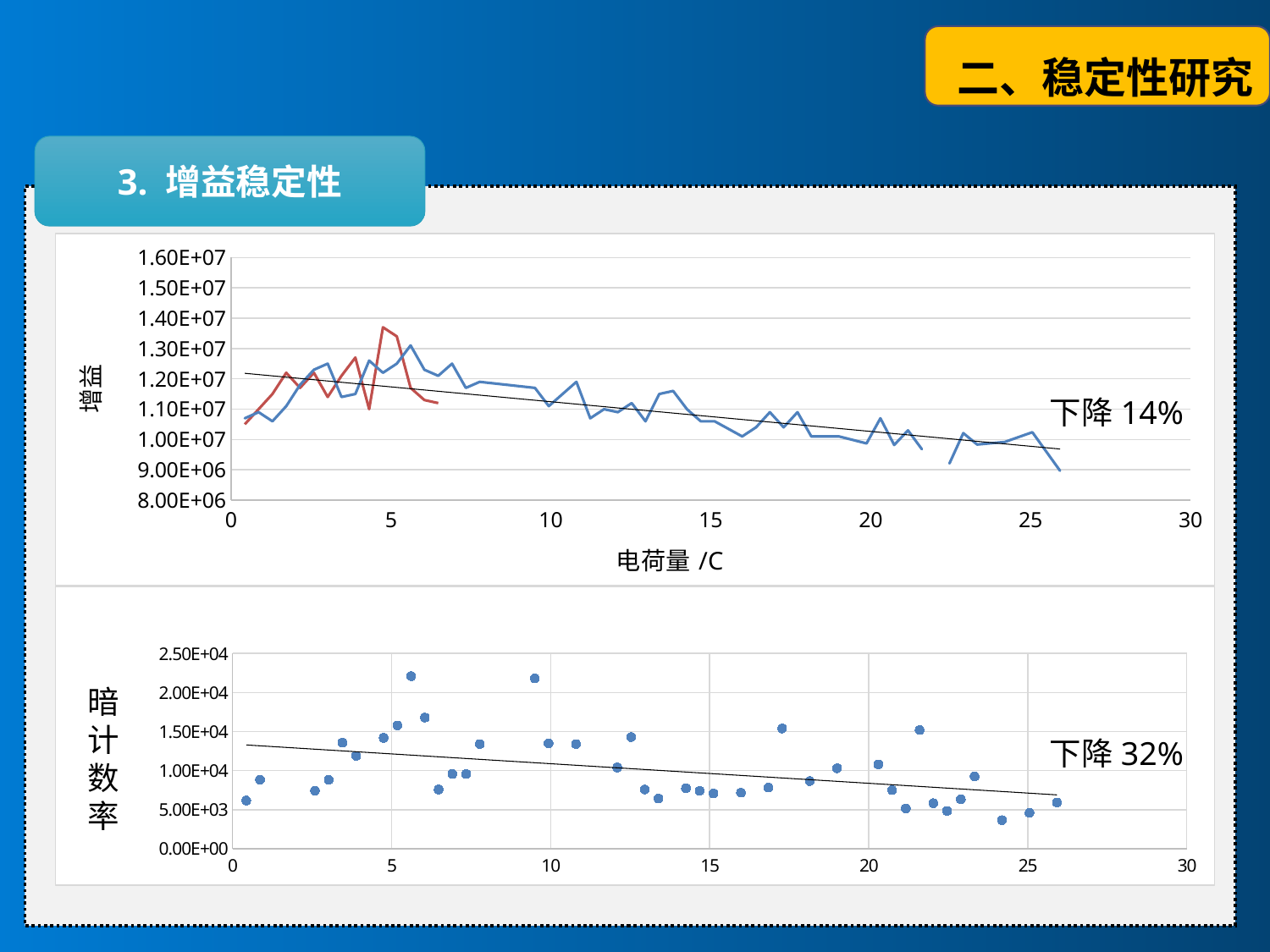
In the bottom chart (暗计数率), is the highest plotted point greater or less than 2.00E+04? greater In the top chart (增益), do the values generally rise or fall as 电荷量 increases? fall In the bottom chart (暗计数率), what percentage decrease is annotated next to the trend line? 下降 32% What kind of chart is the bottom chart (暗计数率)? scatter chart In the top chart (增益), how many data lines are plotted (not counting the straight trend line)? 2 What is the y-axis label of the bottom chart? 暗计数率 What kind of chart is the top chart (增益 vs 电荷量)? line chart In the top chart (增益), is the red line's peak value greater or less than 1.30E+07? greater In the bottom chart (暗计数率), do the values generally rise or fall as the x-axis value increases? fall In the top chart (增益), is the blue line's value at the far right end (around x = 26) greater or less than 1.00E+07? less What is the x-axis title of the top chart? 电荷量 /C In the top chart (增益), what percentage decrease is annotated next to the trend line? 下降 14%